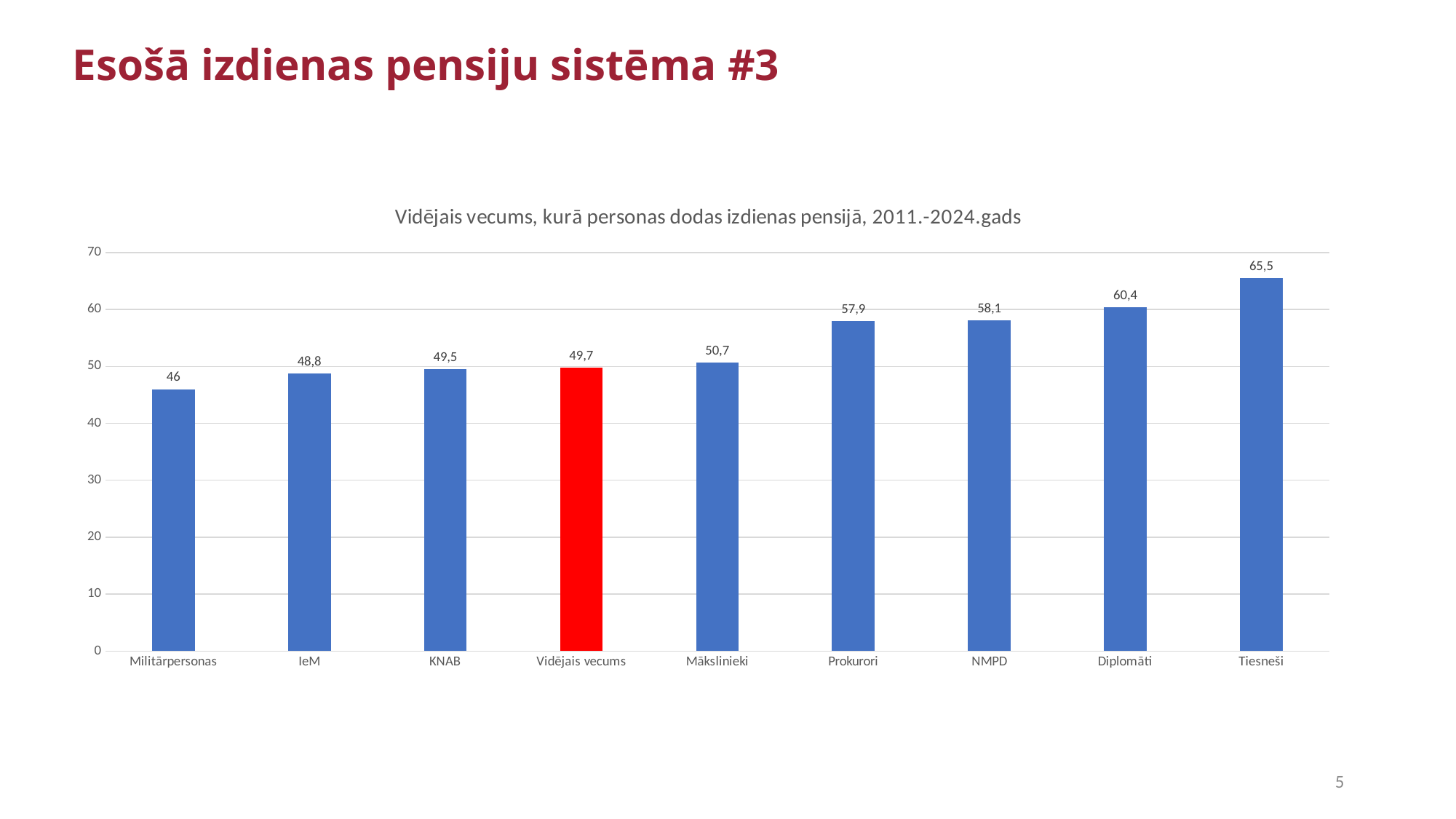
What is the value for Militārpersonas? 46 What is the value for Tiesneši? 65,5 What kind of chart is shown on the slide? Bar chart What is the value for the red bar, Vidējais vecums? 49,7 What is the title of the chart? Vidējais vecums, kurā personas dodas izdienas pensijā, 2011.-2024.gads Which is larger, the value for Diplomāti or the value for NMPD? Diplomāti What is the difference between the values for Tiesneši and Militārpersonas? 19,5 How many categories are shown on the x axis? 9 What is the value for Prokurori? 57,9 Which category has the lowest value? Militārpersonas Which category has the highest value? Tiesneši Is the value for Mākslinieki greater or less than 50? greater